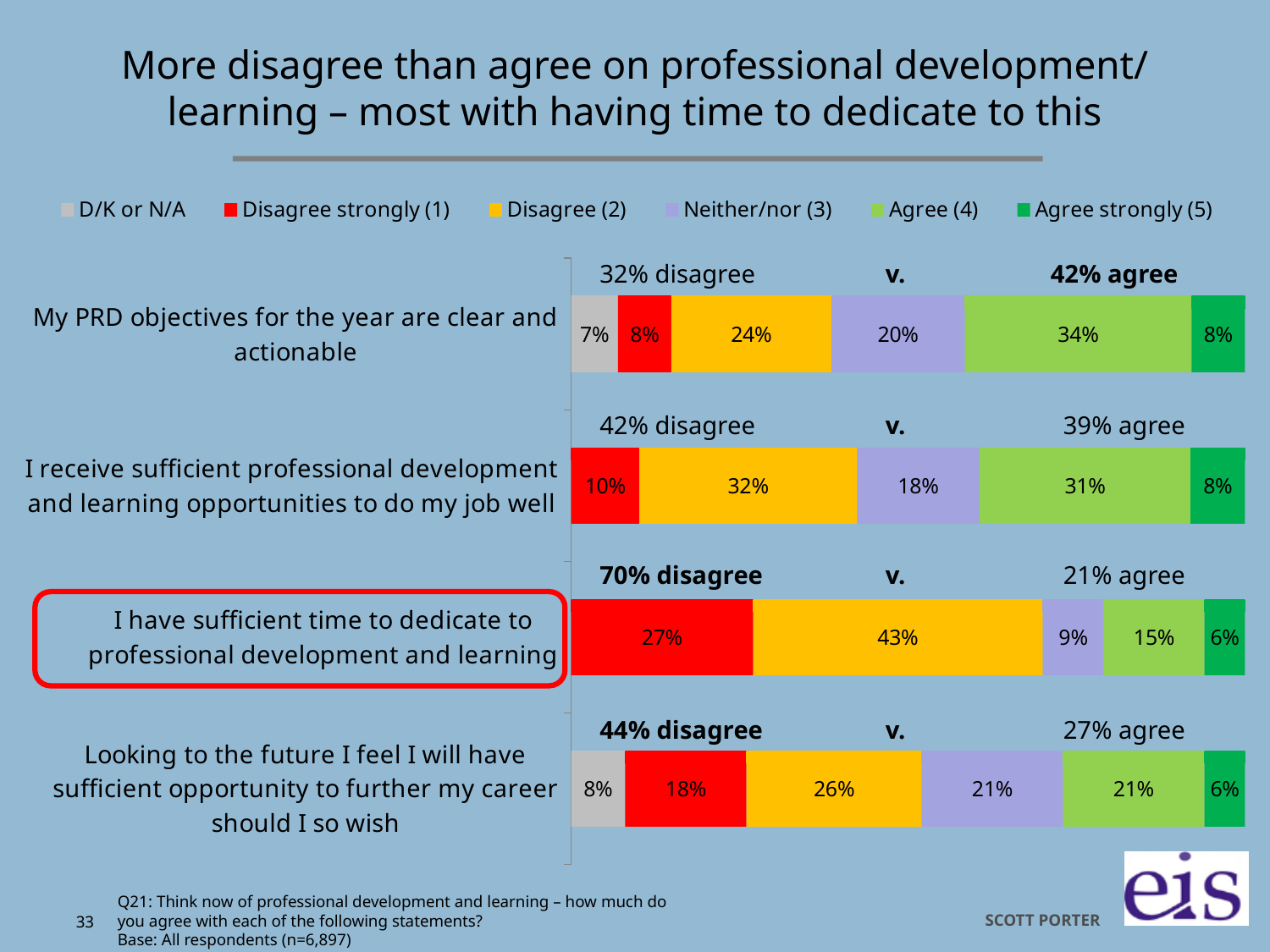
Which statement has the lowest 'Agree (4)' value? I have sufficient time to dedicate to professional development and learning What is the difference between the 'Disagree (2)' values for 'I have sufficient time to dedicate to professional development and learning' and 'My PRD objectives for the year are clear and actionable'? 19% Which is larger: the 'Agree (4)' value for 'My PRD objectives for the year are clear and actionable' or for 'Looking to the future I feel I will have sufficient opportunity to further my career should I so wish'? My PRD objectives for the year are clear and actionable What kind of chart is shown on the slide? Stacked bar chart How many statements (categories) are plotted in the chart? 4 What total 'disagree' percentage is shown above the bar for 'I have sufficient time to dedicate to professional development and learning'? 70% disagree What is the 'Neither/nor (3)' value for 'I receive sufficient professional development and learning opportunities to do my job well'? 18% What is the 'Disagree (2)' value for 'I have sufficient time to dedicate to professional development and learning'? 43% Which statement has the highest 'Disagree strongly (1)' value? I have sufficient time to dedicate to professional development and learning What is the 'Disagree strongly (1)' value for 'Looking to the future I feel I will have sufficient opportunity to further my career should I so wish'? 18% How many series does the legend list? 6 What is the 'Agree (4)' value for 'My PRD objectives for the year are clear and actionable'? 34%